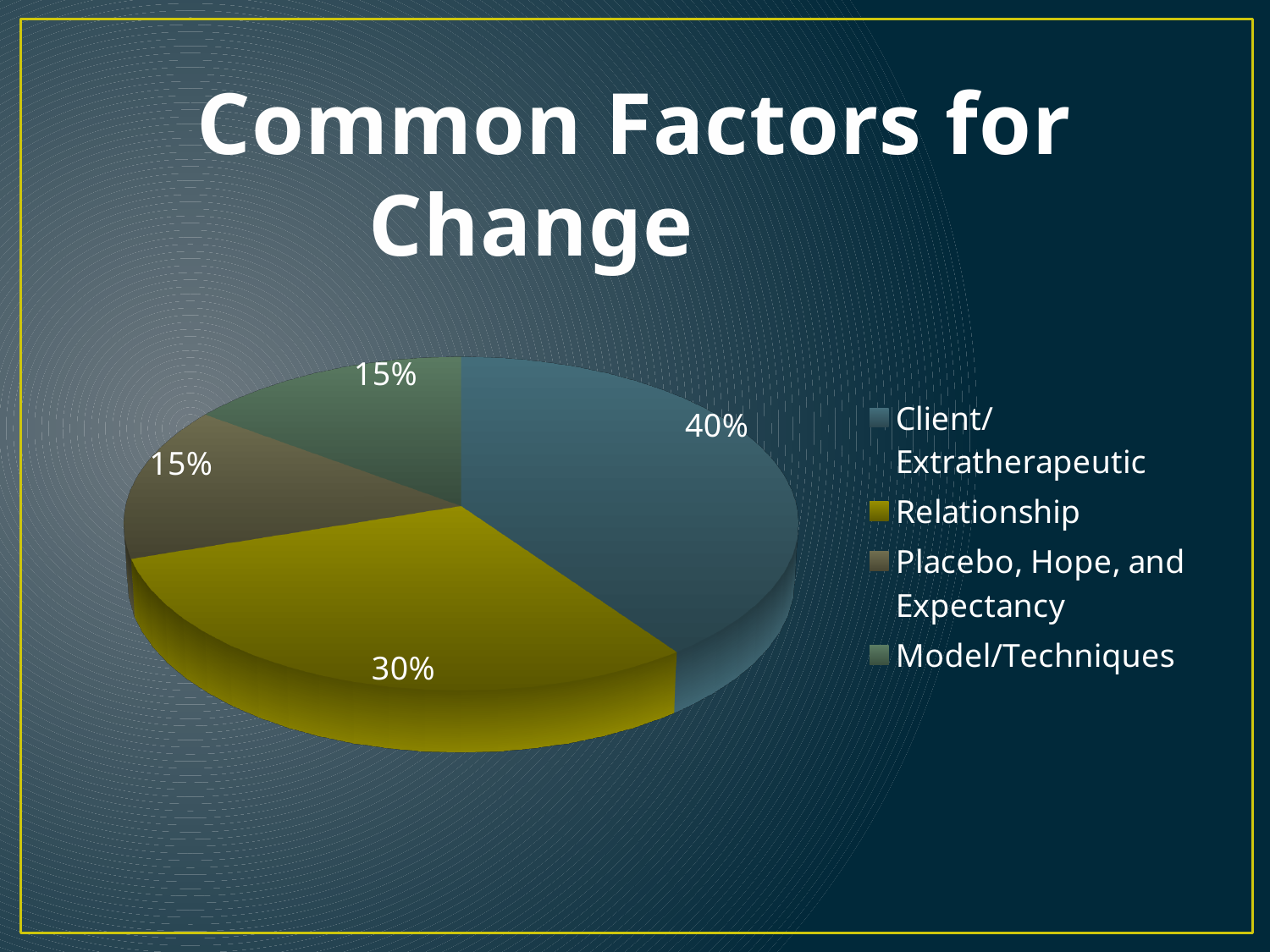
What is the difference in percentage points between Client/Extratherapeutic and Relationship? 10% What is the difference in percentage points between Relationship and Model/Techniques? 15% How many entries does the legend list? 4 What share of the pie does Client/Extratherapeutic account for? 40% Which category has the largest slice of the pie? Client/Extratherapeutic What share of the pie does Relationship account for? 30% What kind of chart is shown on the slide? Pie chart What share of the pie does Model/Techniques account for? 15% What is the title of the slide containing the pie chart? Common Factors for Change Which is larger, the Relationship slice or the Placebo, Hope, and Expectancy slice? Relationship How many slices does the pie chart have? 4